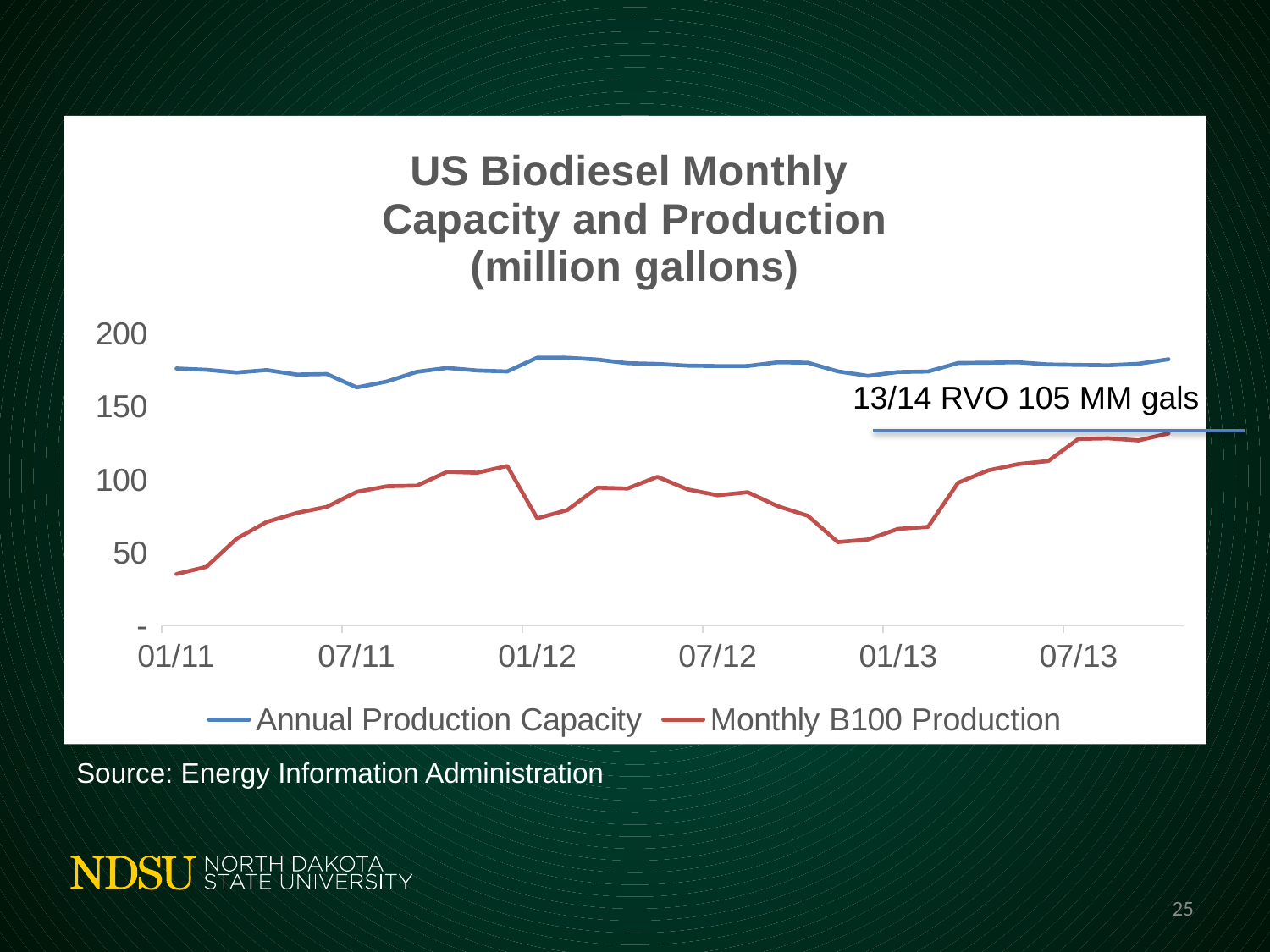
Does Monthly B100 Production rise or fall between 01/11 and 07/11? rise What is the title of the chart? US Biodiesel Monthly Capacity and Production (million gallons) Is the value for Annual Production Capacity at 01/11 greater or less than 150? greater What kind of chart is shown on the slide? line chart Is the value for Annual Production Capacity at 07/11 greater or less than 150? greater Is the value for Monthly B100 Production at 01/12 greater or less than 100? less At 01/11, which series has the higher value, Annual Production Capacity or Monthly B100 Production? Annual Production Capacity How many series does the legend list? 2 How many date labels are shown on the x axis? 6 What are the two series named in the legend? Annual Production Capacity and Monthly B100 Production